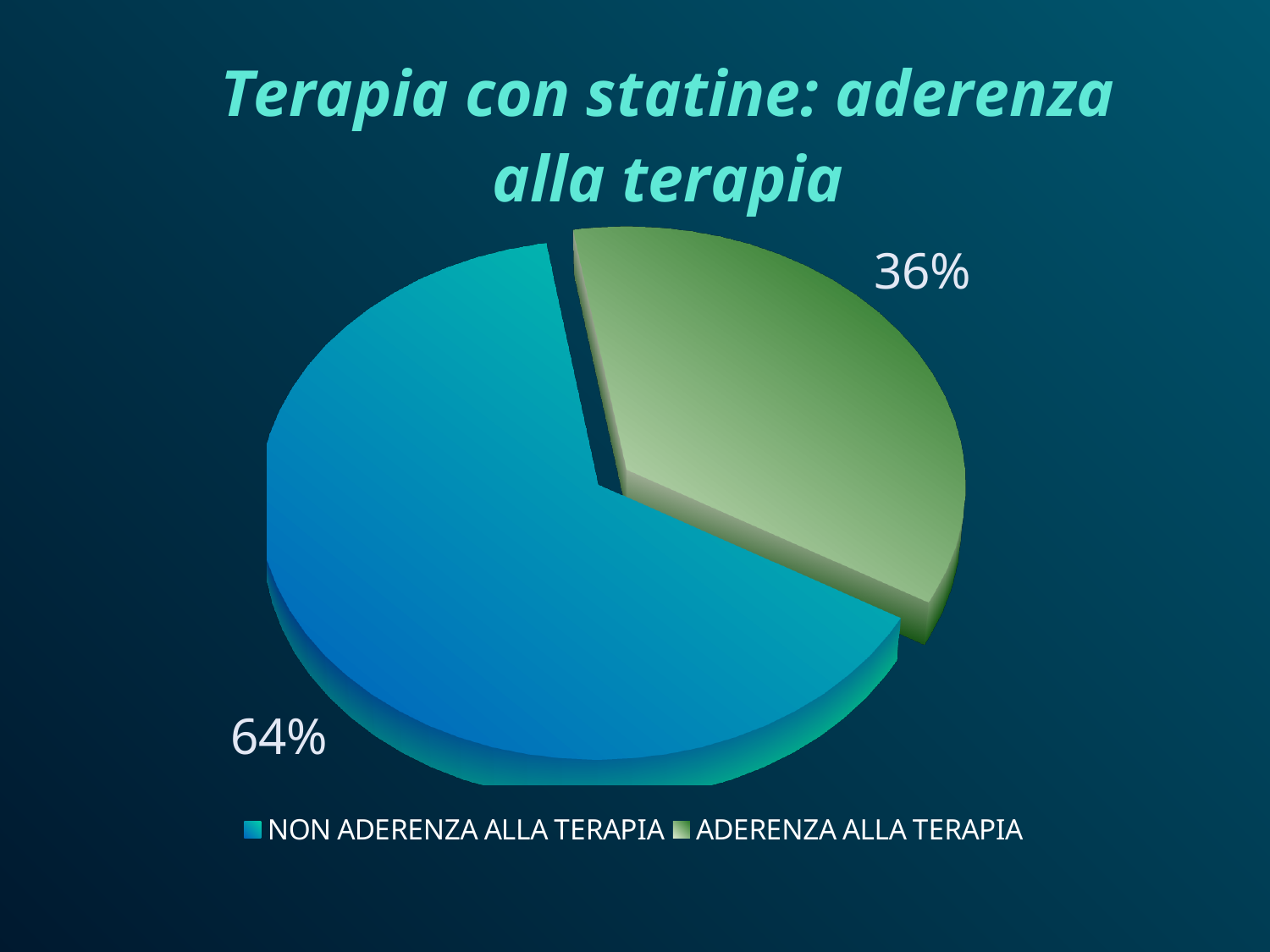
What kind of chart is shown on the slide? Pie chart How many slices does the pie chart have? 2 Which slice of the pie is the smallest? ADERENZA ALLA TERAPIA What percentage of the pie is labelled ADERENZA ALLA TERAPIA? 36% Which is larger: the share for ADERENZA ALLA TERAPIA or the share for NON ADERENZA ALLA TERAPIA? NON ADERENZA ALLA TERAPIA What is the difference in percentage points between the NON ADERENZA ALLA TERAPIA slice and the ADERENZA ALLA TERAPIA slice? 28 What colour is the ADERENZA ALLA TERAPIA slice? Green How many entries does the legend list? 2 What is the title of the chart? Terapia con statine: aderenza alla terapia What percentage of the pie is labelled NON ADERENZA ALLA TERAPIA? 64% What share of the pie does the ADERENZA ALLA TERAPIA slice represent? 36% Which slice of the pie is the largest? NON ADERENZA ALLA TERAPIA